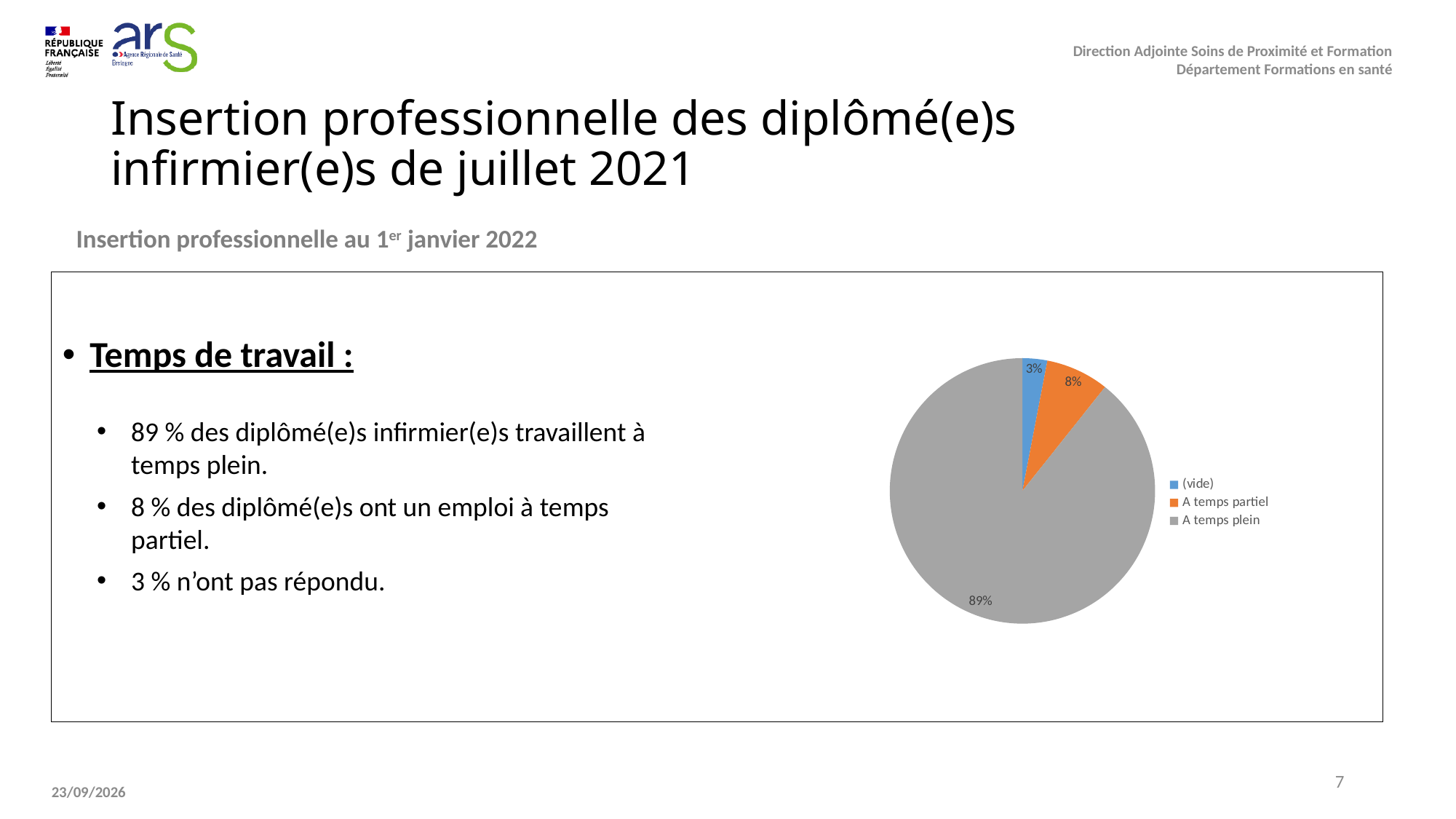
What share of the pie does "(vide)" represent? 3% What is the difference in percentage points between "A temps plein" and "A temps partiel"? 81 Which category has the largest slice of the pie? A temps plein How many entries does the legend list? 3 What kind of chart is shown on the slide? pie chart What share of the pie does "A temps partiel" represent? 8% Which category has the smallest slice of the pie? (vide) How many slices does the pie chart have? 3 Which is larger, the slice for "A temps partiel" or the slice for "(vide)"? A temps partiel What share of the pie does "A temps plein" represent? 89% What colour is the "A temps plein" slice? grey What colour is the "(vide)" slice? blue